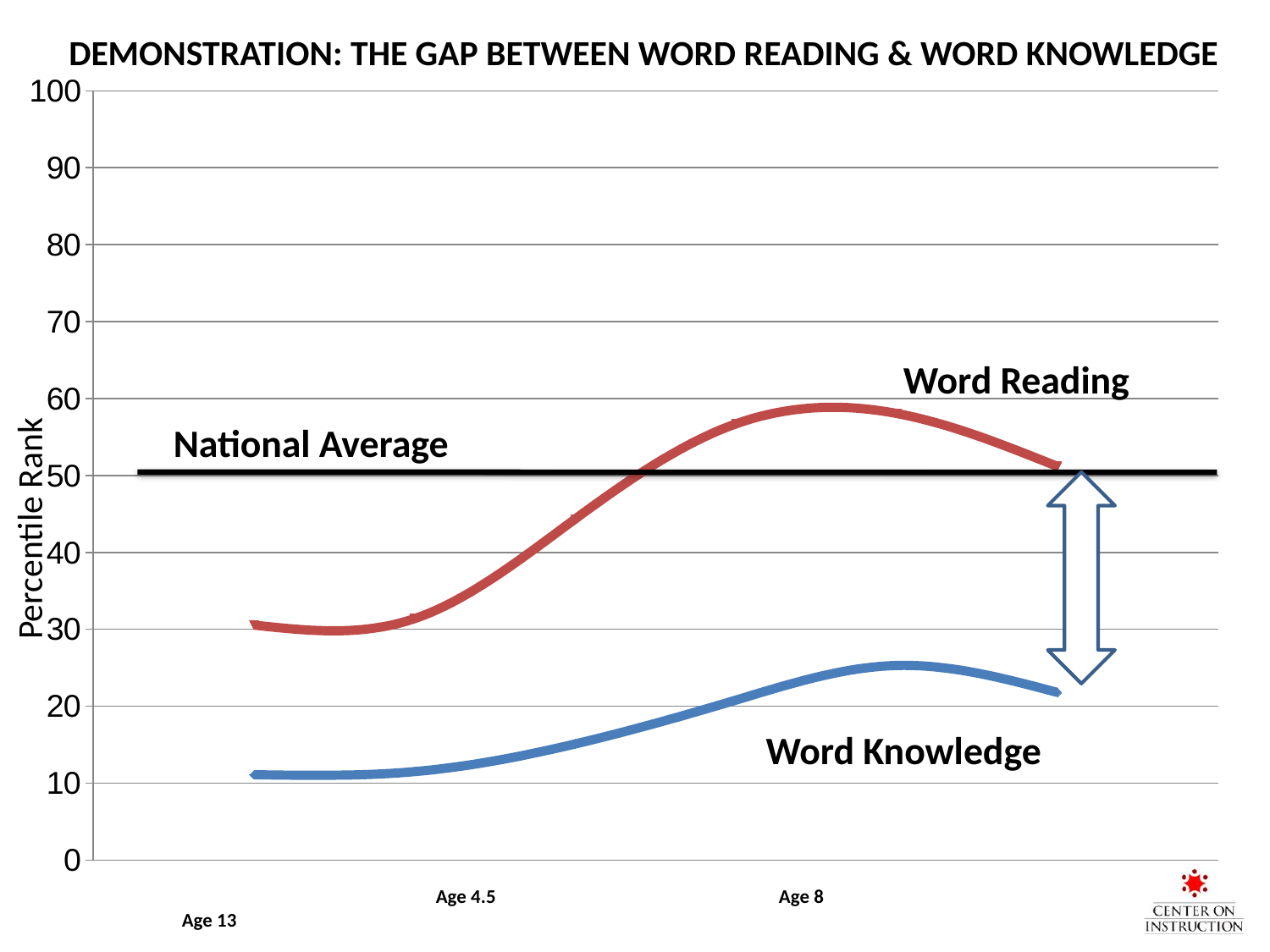
Is the highest point of the Word Knowledge line greater or less than 30? less Is the highest point of the Word Reading line greater or less than 50? greater Is the National Average line greater or less than 40? greater What kind of chart is shown on the slide? line chart What is the title of the chart? DEMONSTRATION: THE GAP BETWEEN WORD READING & WORD KNOWLEDGE How many age labels are shown along the horizontal axis? 3 Does the Word Knowledge line generally rise or fall from left to right? rise Which line is higher across the whole chart, Word Reading or Word Knowledge? Word Reading At its peak, is the Word Reading line above or below the National Average line? above What is the label on the vertical axis? Percentile Rank